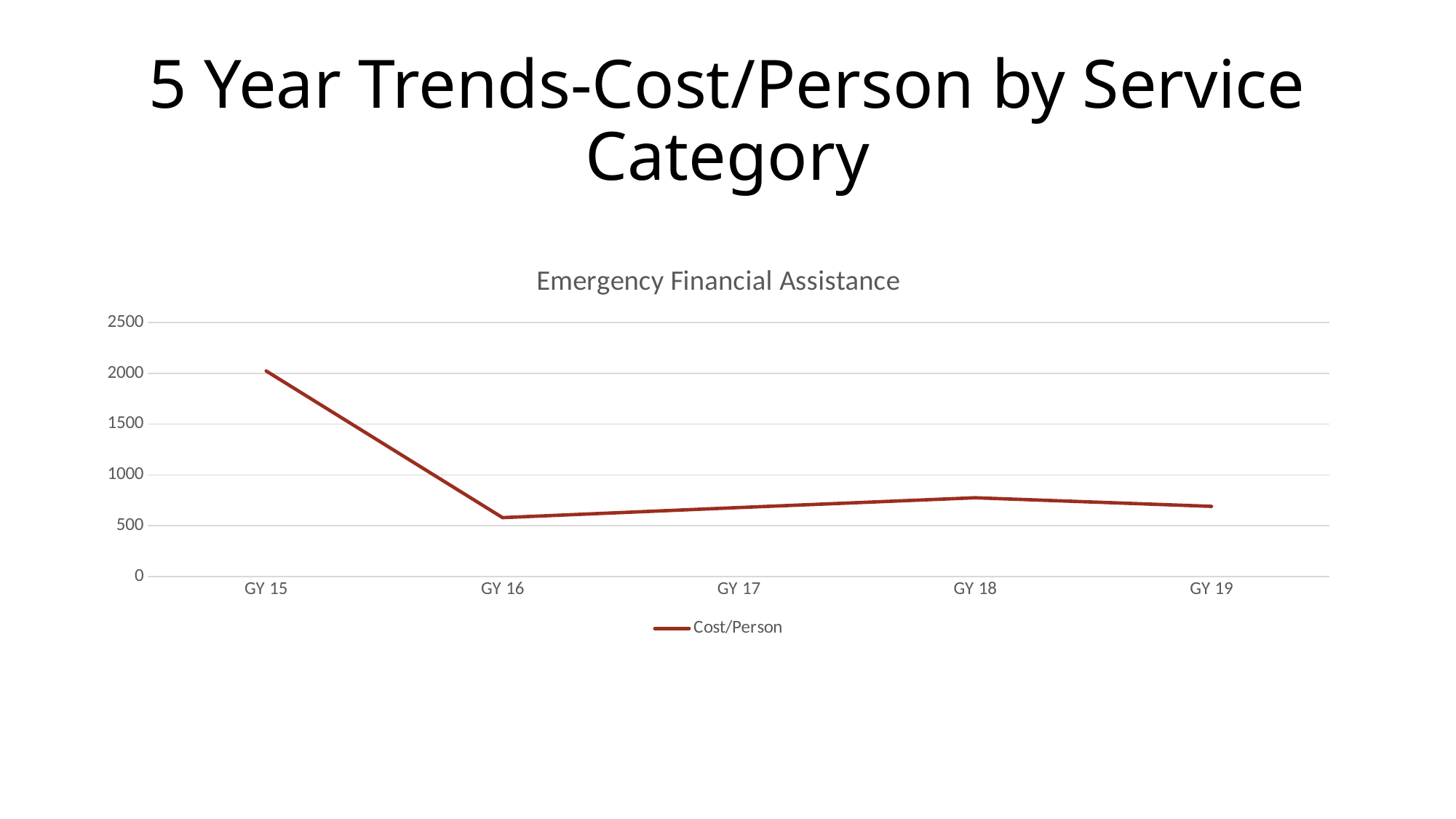
Is the Cost/Person for GY 18 greater or less than 1000? less How many series does the legend list? 1 What kind of chart is shown on the slide? line chart What is the title of the chart? Emergency Financial Assistance Which grant year has the highest Cost/Person? GY 15 Which grant year has the lowest Cost/Person? GY 16 Which has a higher Cost/Person, GY 15 or GY 16? GY 15 Is the Cost/Person for GY 16 greater or less than 1000? less How many grant years are plotted on the x axis? 5 What is the name of the series shown in the legend? Cost/Person Is the Cost/Person for GY 15 greater or less than 1500? greater Does the Cost/Person rise or fall from GY 15 to GY 16? fall